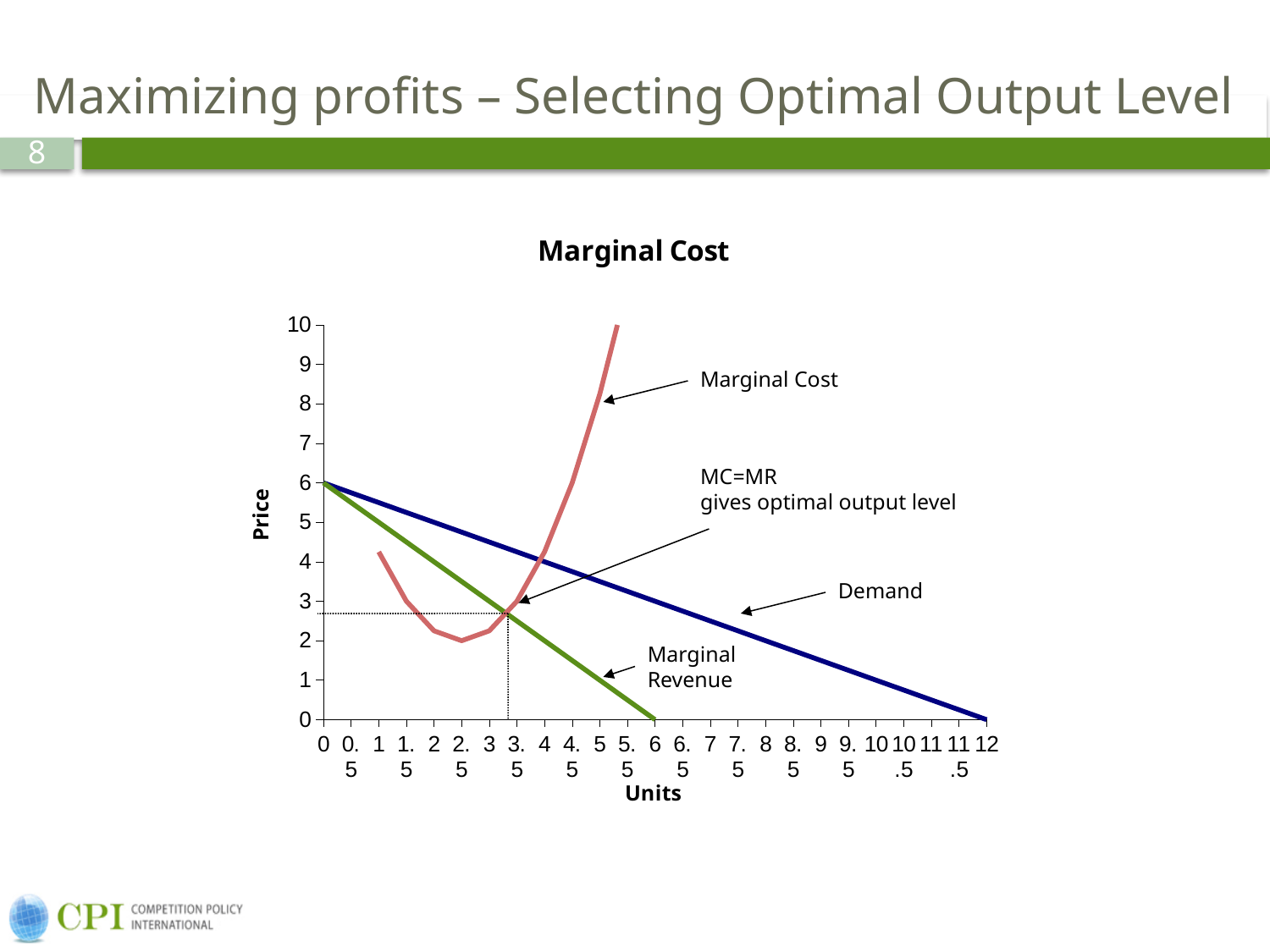
Is the Marginal Cost value at 5 units greater or less than 5? greater Is the Marginal Cost value at 2.5 units greater or less than 3? less What is the value of the Demand line at 0 units? 6 At 5 units, which is larger: the Demand line or the Marginal Revenue line? Demand What is the title of the chart? Marginal Cost At how many units does the Demand line reach a price of 0? 12 Does the Demand line rise or fall as units increase? fall How many lines are plotted on the chart? 3 At how many units does the Marginal Revenue line reach a price of 0? 6 What is the label of the vertical axis? Price What kind of chart is shown on the slide? line chart Is the Demand value at 9 units greater or less than 2? less